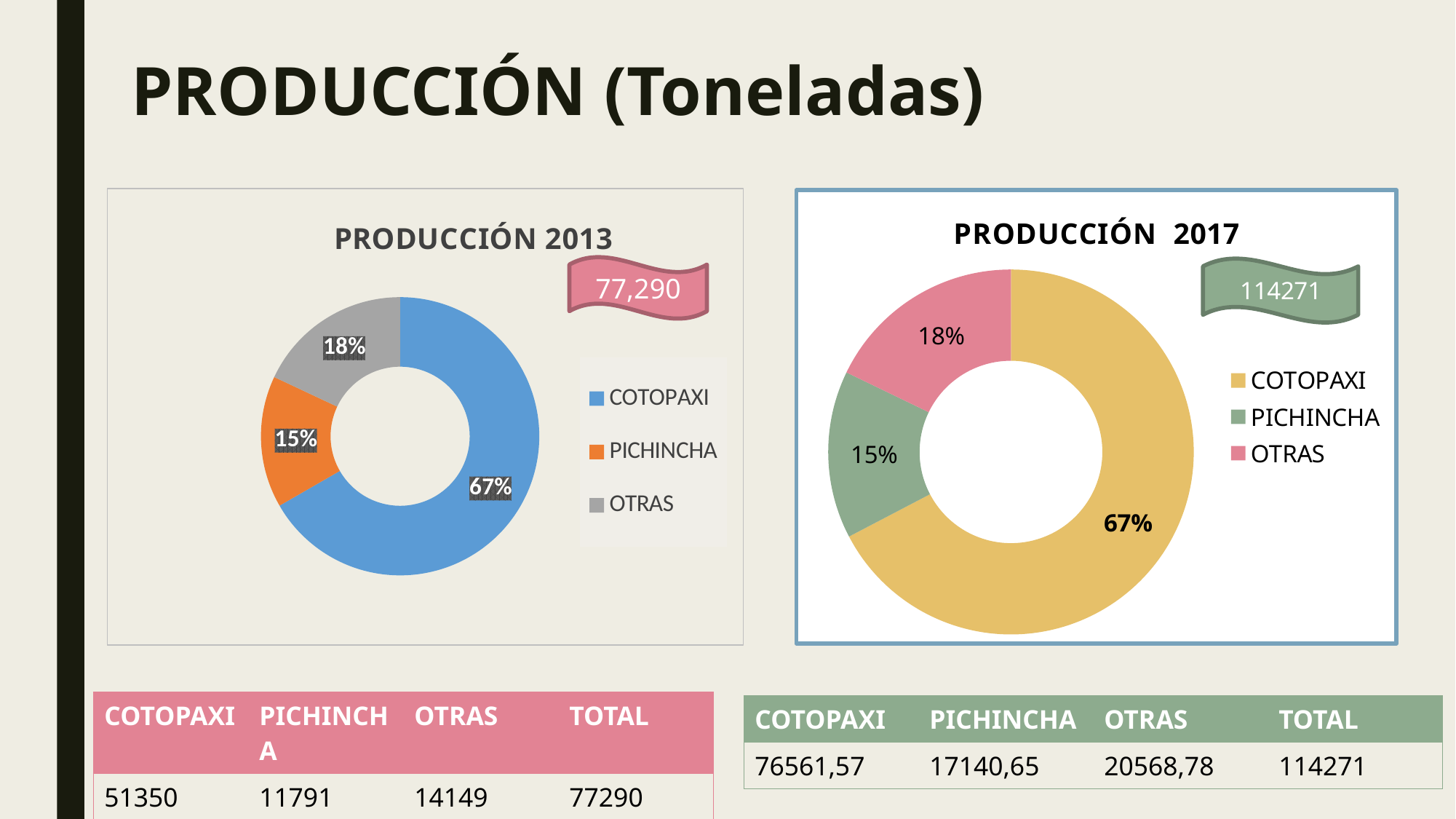
In the PRODUCCIÓN 2017 chart, which category has the largest slice? COTOPAXI In the PRODUCCIÓN 2013 chart, what share of the pie does COTOPAXI have? 67% How many categories does the PRODUCCIÓN 2017 chart show? 3 In the PRODUCCIÓN 2017 chart, what share of the pie does COTOPAXI have? 67% In the PRODUCCIÓN 2013 chart, what share of the pie does PICHINCHA have? 15% In the PRODUCCIÓN 2017 chart, which slice is larger, OTRAS or PICHINCHA? OTRAS In the PRODUCCIÓN 2013 chart, what colour is the COTOPAXI slice? Blue What kind of chart is the PRODUCCIÓN 2013 chart? Doughnut (pie) chart In the PRODUCCIÓN 2013 chart, what is the difference in percentage points between the COTOPAXI and OTRAS slices? 49 In the PRODUCCIÓN 2013 chart, which category has the smallest slice? PICHINCHA